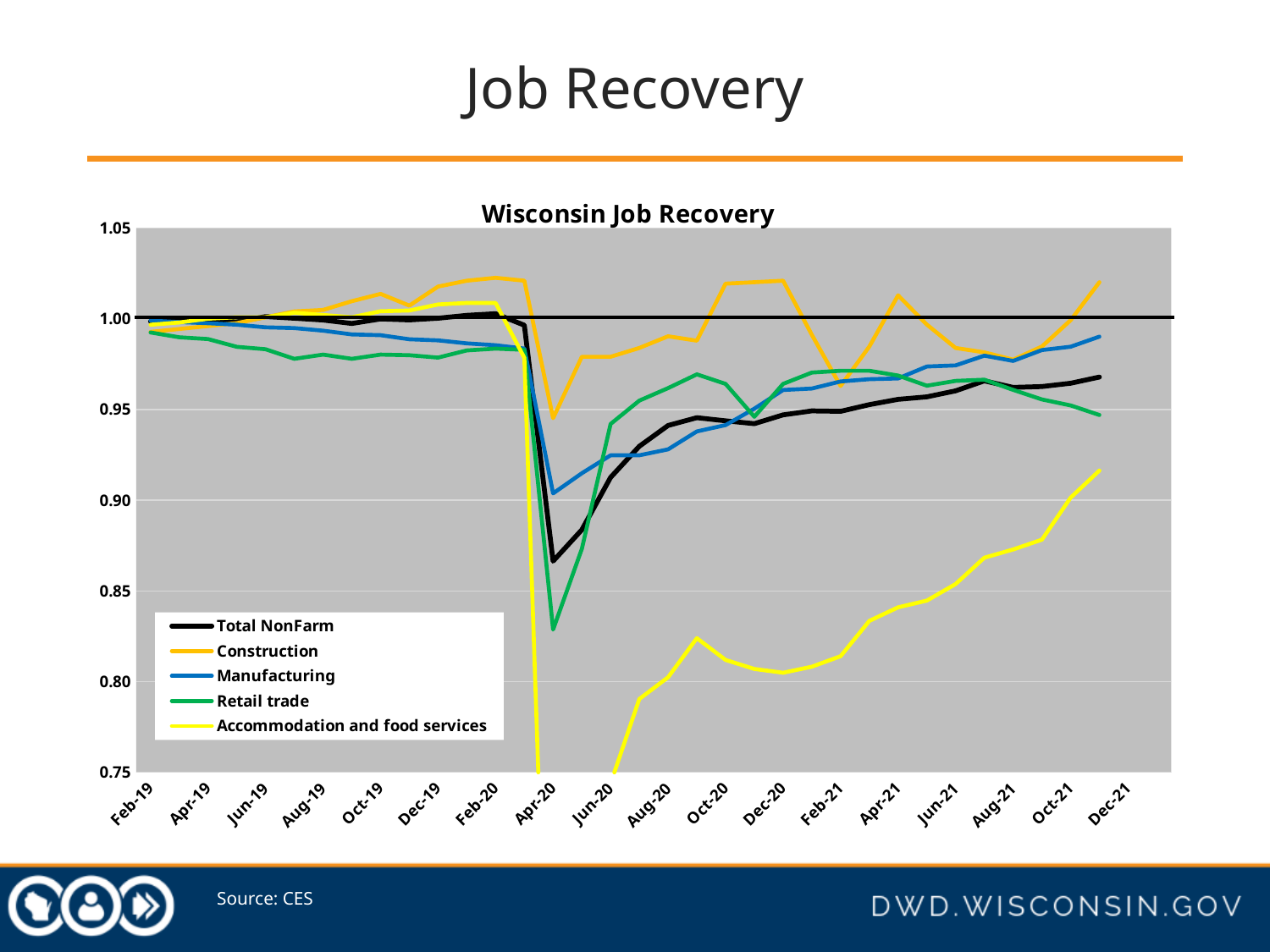
Which series is drawn in yellow? Accommodation and food services Is the value for Retail trade in Apr-20 greater or less than 0.85? less What kind of chart is shown on the slide? Line chart How many series does the legend list? 5 Is the value for Total NonFarm in Apr-20 greater or less than 0.90? less Which series has the lowest value in Apr-20? Accommodation and food services What is the title of the chart? Wisconsin Job Recovery